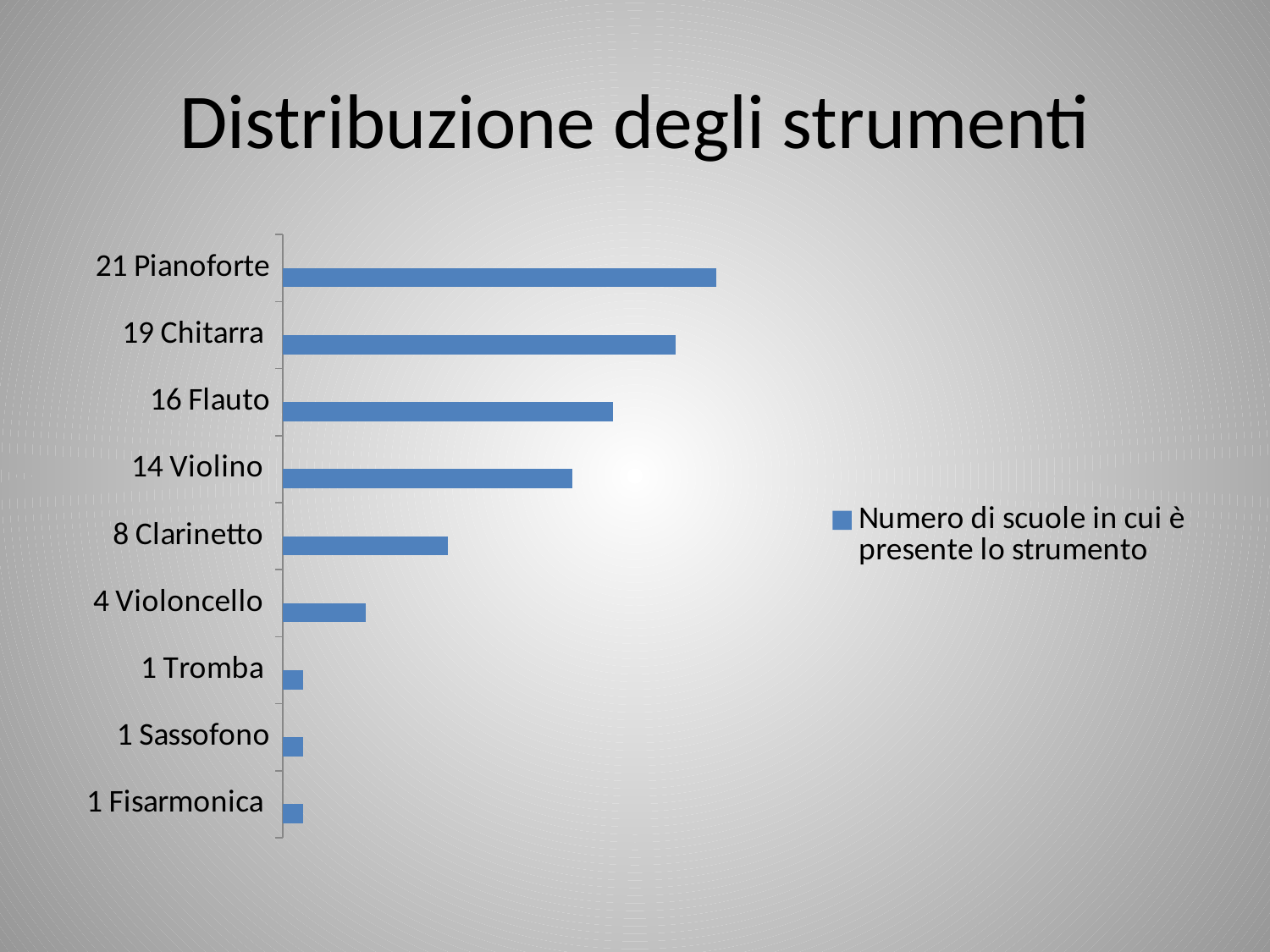
Which instrument has a larger value, Flauto or Violino? Flauto What is the legend entry for the series? Numero di scuole in cui è presente lo strumento How many instrument categories are plotted in the chart? 9 Which instrument has the highest value in the chart? Pianoforte In how many schools is the Pianoforte present, according to the chart? 21 What is the difference between the values for Pianoforte and Chitarra? 2 What is the value shown for Clarinetto? 8 Do the values rise or fall going from the top bar (Pianoforte) to the bottom bar (Fisarmonica)? fall How many series does the legend list? 1 What kind of chart is shown on the slide? bar chart What is the title of the chart? Distribuzione degli strumenti What is the difference between the values for Violino and Violoncello? 10